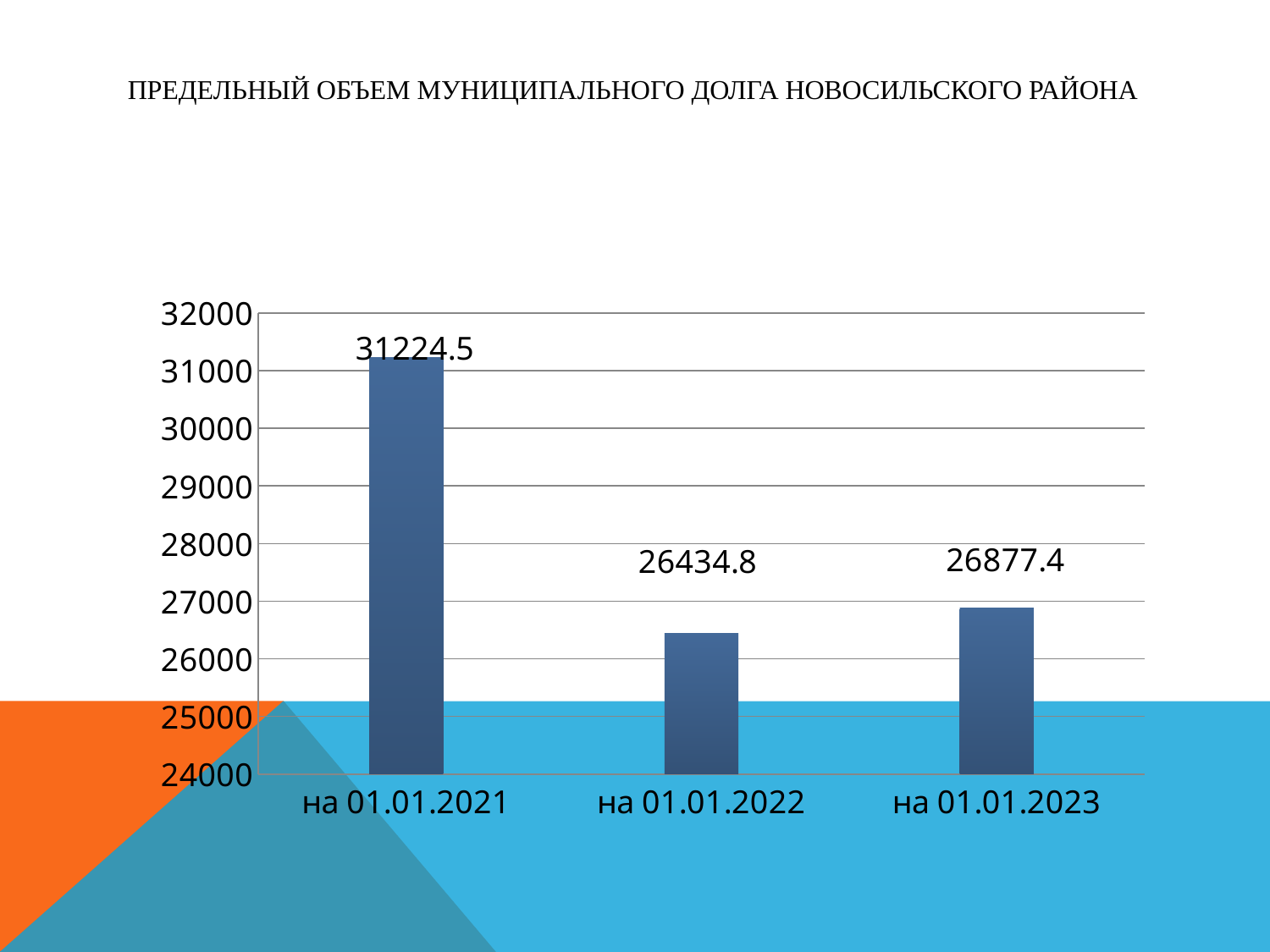
What is the value for на 01.01.2021? 31224.5 What is the value for на 01.01.2023? 26877.4 What is the value for на 01.01.2022? 26434.8 What kind of chart is shown on the slide? bar chart Which category has the lowest value? на 01.01.2022 Which category has the highest value? на 01.01.2021 Which is larger, the value for на 01.01.2022 or на 01.01.2023? на 01.01.2023 How many categories are shown on the x axis? 3 What is the difference between the values for на 01.01.2023 and на 01.01.2022? 442.6 What is the title of the slide? ПРЕДЕЛЬНЫЙ ОБЪЕМ МУНИЦИПАЛЬНОГО ДОЛГА НОВОСИЛЬСКОГО РАЙОНА Is the value for на 01.01.2021 greater or less than 30000? greater What is the difference between the values for на 01.01.2021 and на 01.01.2022? 4789.7